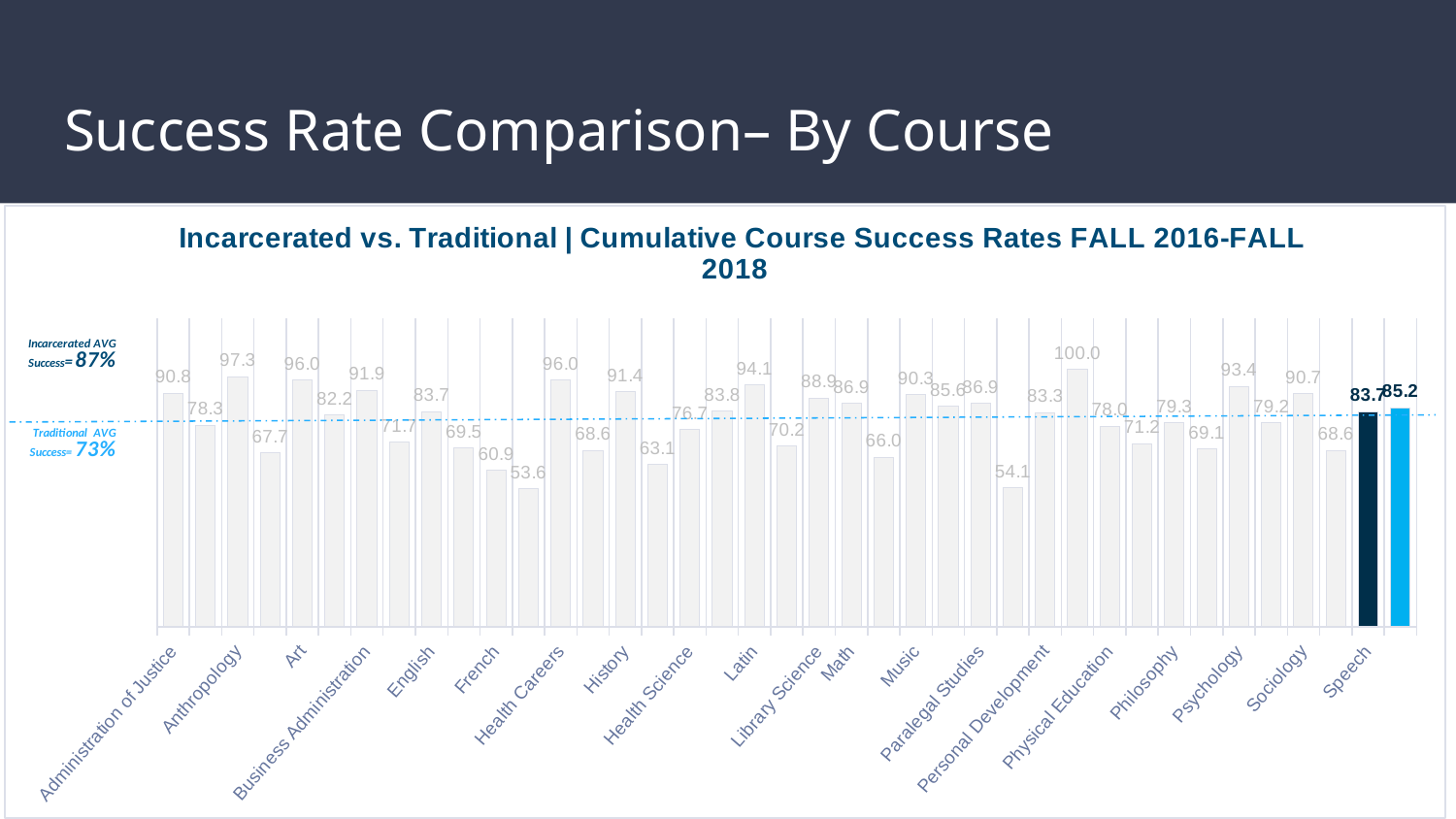
What Incarcerated AVG Success rate is noted on the left of the chart? 87% What is the difference between the two Speech bars (85.2 and 83.7)? 1.5 What kind of chart is shown on the slide? bar chart What is the value of the left bar for Administration of Justice? 90.8 What is the title of the chart? Incarcerated vs. Traditional | Cumulative Course Success Rates FALL 2016-FALL 2018 What is the value of the light blue highlighted bar for Speech? 85.2 What is the value of the dark blue highlighted bar for Speech? 83.7 Which of the two Speech bars is larger, the dark blue one or the light blue one? the light blue one How many courses are listed along the x axis of the chart? 20 What is the highest value labelled on any bar in the chart? 100.0 What is the lowest value labelled on any bar in the chart? 53.6 What is the value of the left bar for Anthropology? 97.3